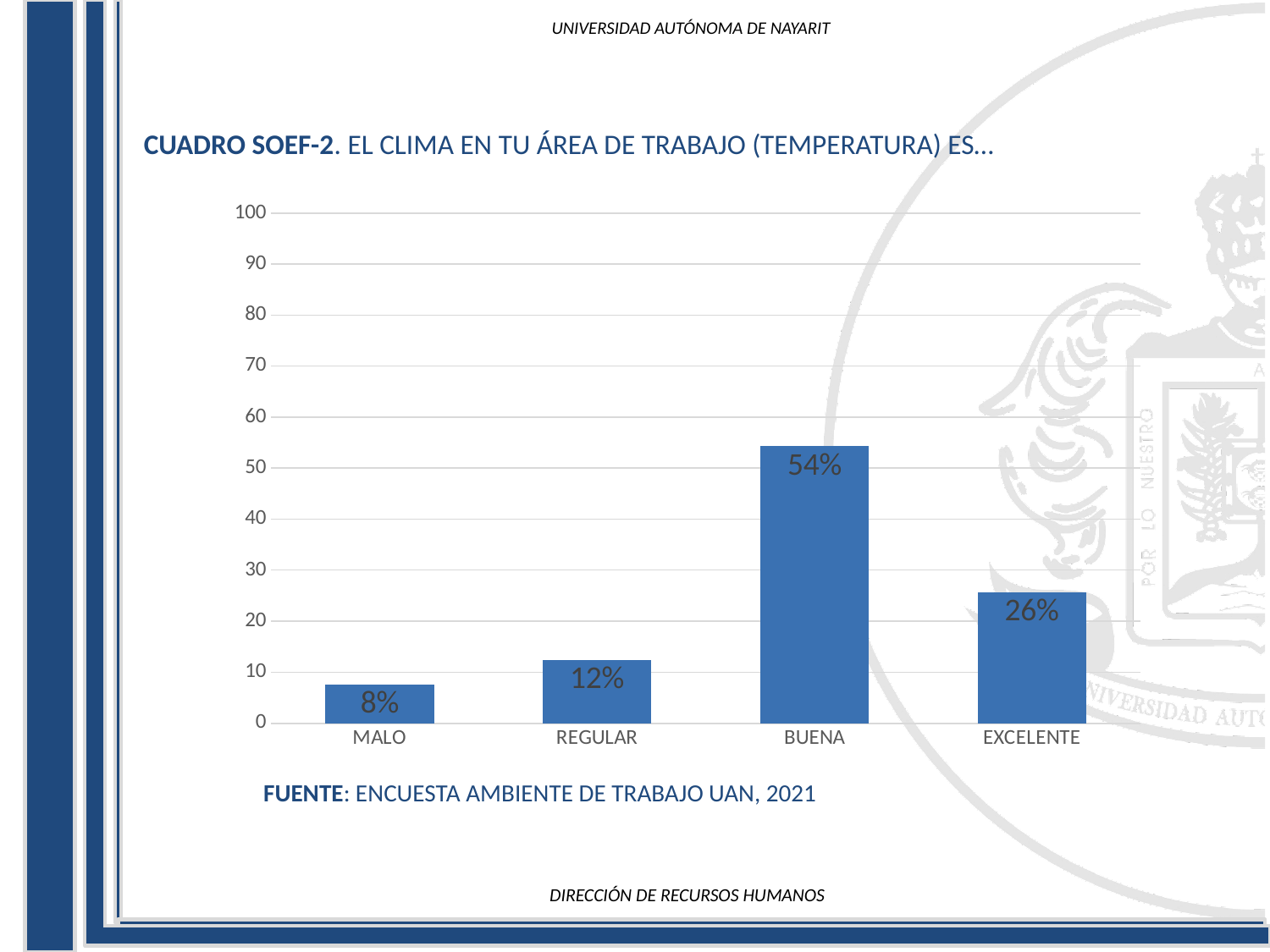
Which is larger, the value for REGULAR or the value for EXCELENTE? EXCELENTE What is the difference between the values for BUENA and EXCELENTE? 28% What is the value for MALO? 8% What kind of chart is shown on the slide? bar chart What is the value for REGULAR? 12% What source is cited below the chart? ENCUESTA AMBIENTE DE TRABAJO UAN, 2021 How many categories are shown on the x axis? 4 Which category has the lowest value? MALO What is the value for BUENA? 54% Which category has the highest value? BUENA Is the value for BUENA greater or less than 50? greater What is the value for EXCELENTE? 26%